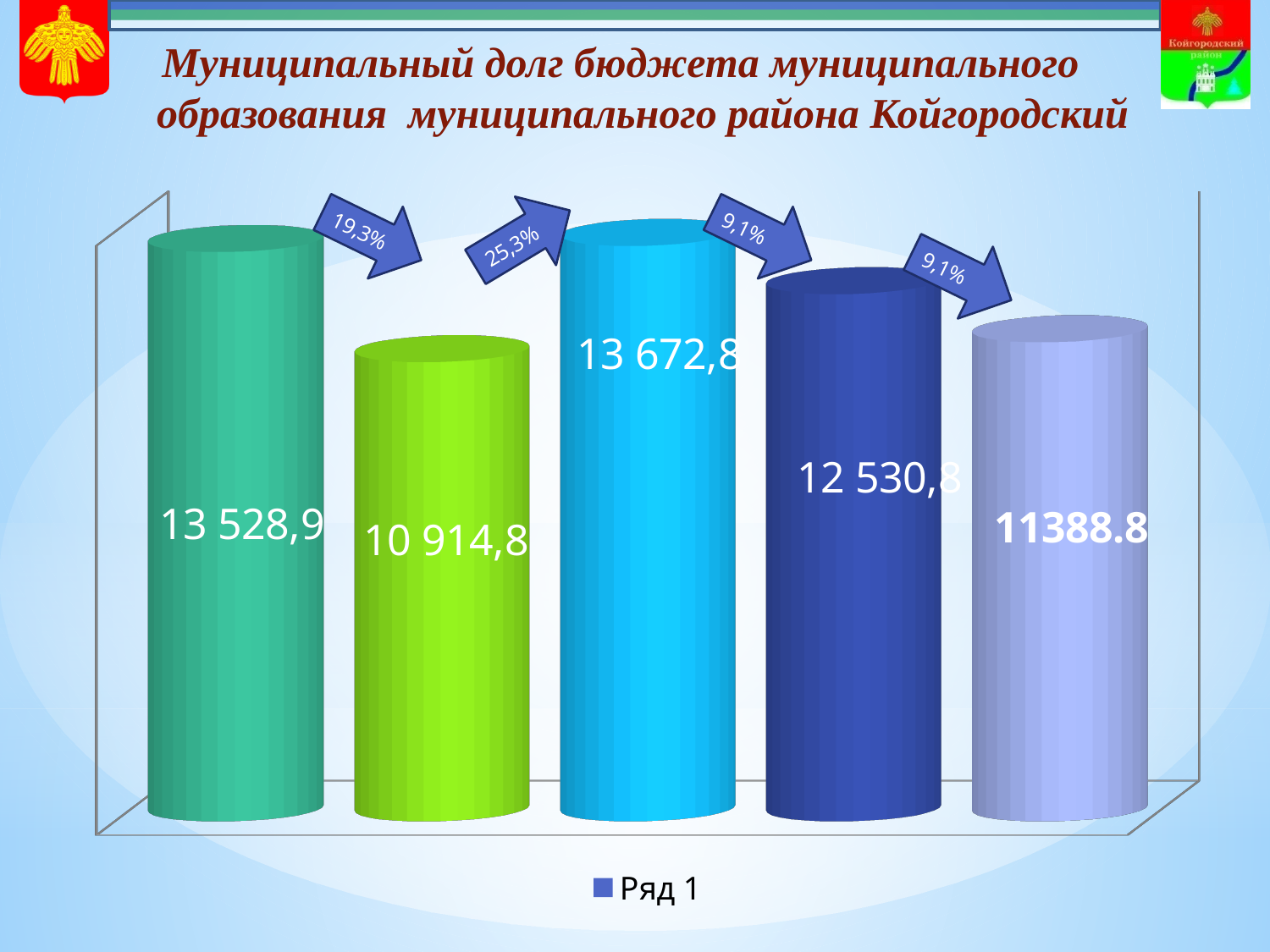
What is the difference between the first bar (13 528,9) and the second bar (10 914,8)? 2 614,1 What is the value shown on the fifth (lavender) bar? 11388.8 What is the value shown on the first (teal) bar? 13 528,9 What is the value shown on the third (light blue) bar? 13 672,8 Which is larger, the value of the fourth bar or the value of the fifth bar? The fourth bar (12 530,8) What is the value shown on the fourth (dark blue) bar? 12 530,8 How many bars are plotted in the chart? 5 Which bar has the lowest value? The second (green) bar What is the value shown on the second (green) bar? 10 914,8 Which bar has the highest value? The third (light blue) bar What kind of chart is shown on the slide? Bar chart How many series does the legend list? 1